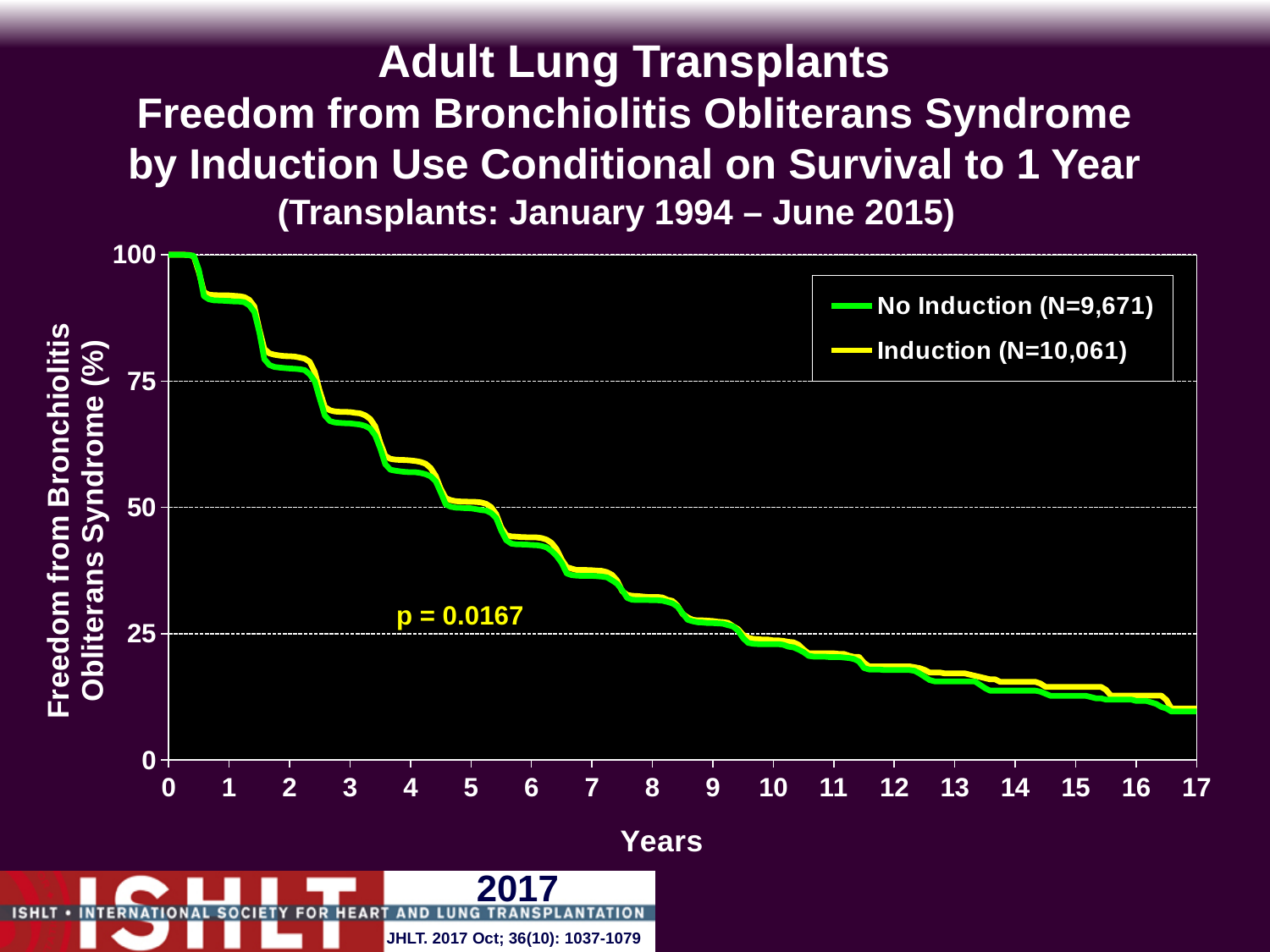
Is the value for the Induction curve at year 1 greater or less than 75? greater What is the label of the x axis? Years Is the value for the No Induction curve at year 16 greater or less than 25? less What is the N for the Induction group shown in the legend? 10,061 Is the value for the No Induction curve at year 3 greater or less than 75? less What is the N for the No Induction group shown in the legend? 9,671 Do the curves rise or fall as years increase along the x axis? fall What p-value is printed on the chart? p = 0.0167 How many series does the legend list? 2 What kind of chart is shown on the slide? line chart